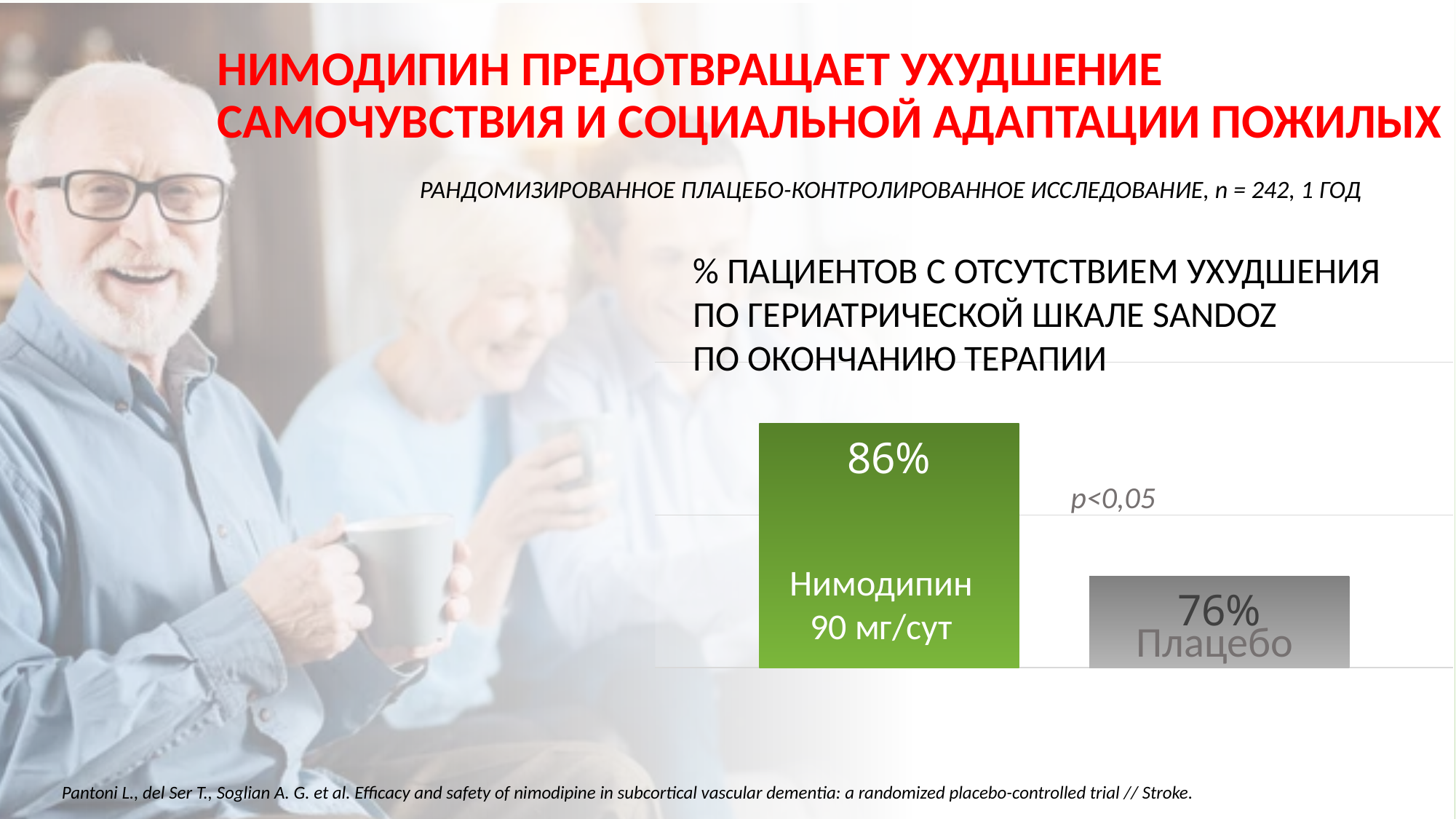
What is the value for Нимодипин 90 мг/сут? 86% Which category has the highest value? Нимодипин 90 мг/сут What colour is the bar for Нимодипин 90 мг/сут? Green Which category has the lowest value? Плацебо What is the value for Плацебо? 76% How many categories are shown in the chart? 2 What kind of chart is shown on the slide? Bar chart What is the difference between the values for Нимодипин 90 мг/сут and Плацебо? 10% What p-value is shown on the chart? p<0,05 Which is larger, the value for Нимодипин 90 мг/сут or the value for Плацебо? Нимодипин 90 мг/сут